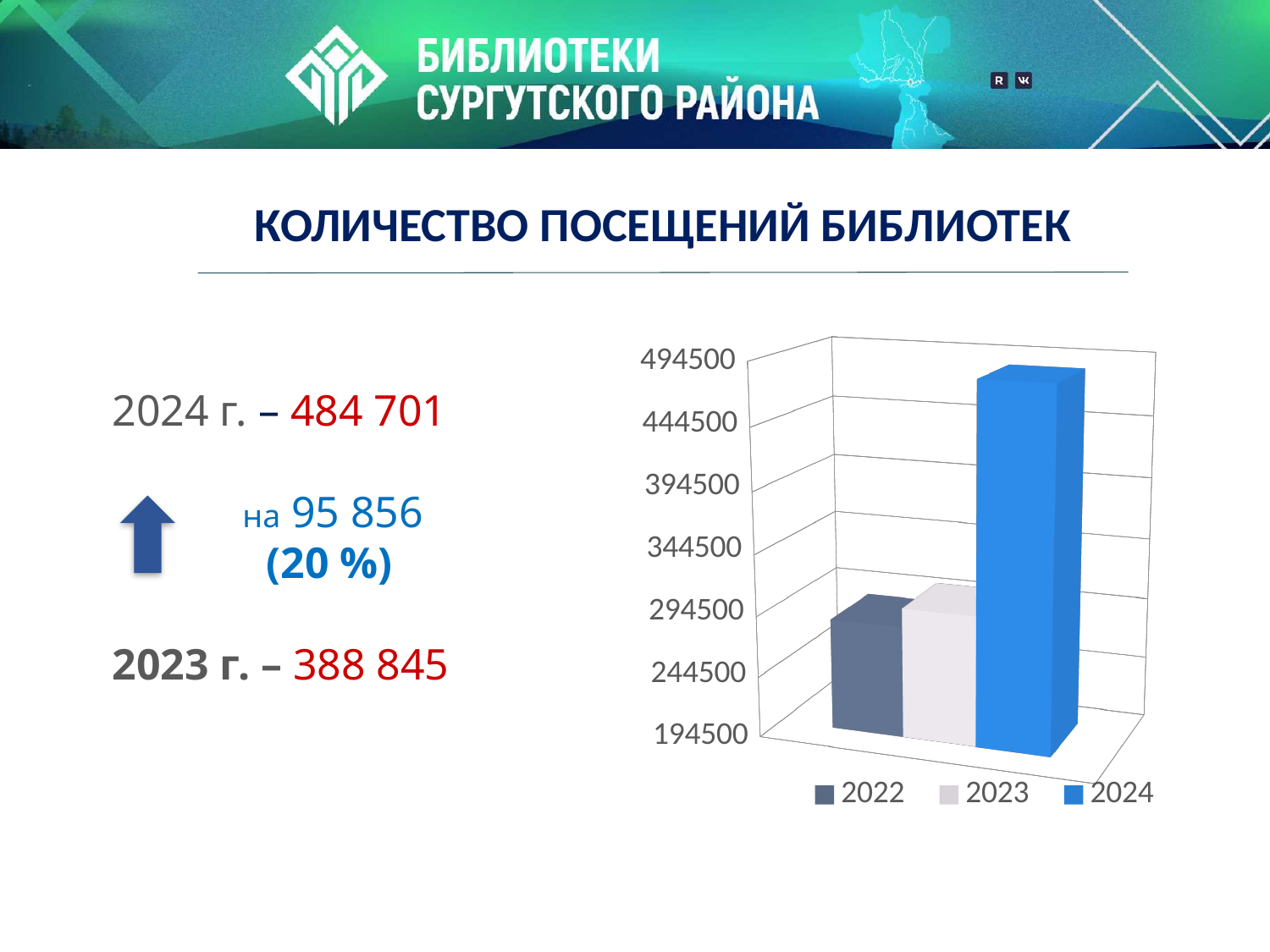
How many series does the chart legend list? 3 Which year has the highest number of library visits? 2024 What kind of chart is shown on the slide? Bar chart What is the number of library visits for 2023? 388 845 What is the title of the chart on the slide? КОЛИЧЕСТВО ПОСЕЩЕНИЙ БИБЛИОТЕК Which year has the lowest number of library visits? 2022 What is the number of library visits for 2024? 484 701 Is the value for 2022 greater or less than 344500? less How many bars are plotted in the chart? 3 By how much did library visits increase from 2023 to 2024? 95 856 Which year has more library visits, 2023 or 2024? 2024 Do the values rise or fall from 2022 to 2024? rise